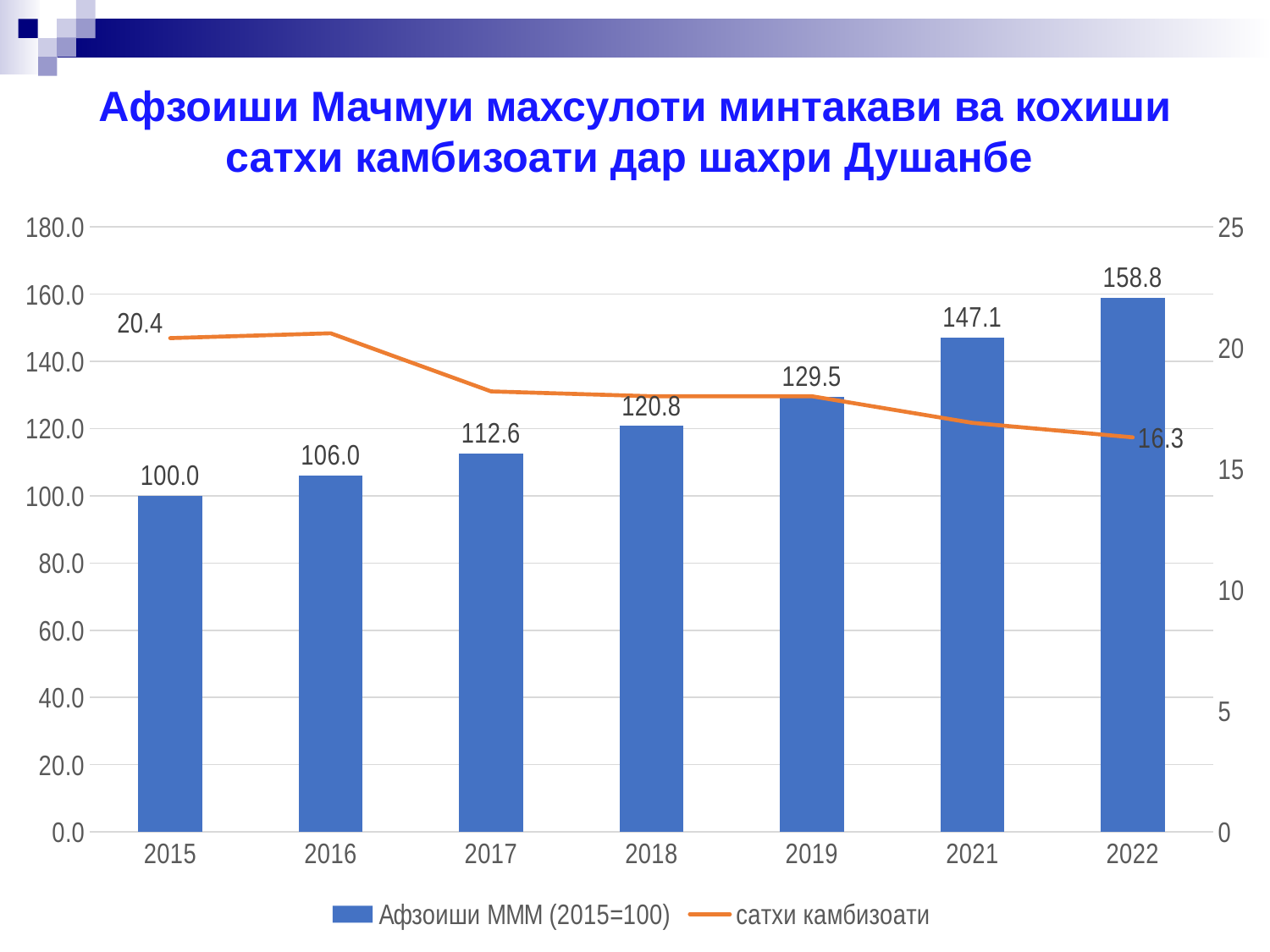
How many series does the legend list? 2 What is the value of сатхи камбизоати for 2022? 16.3 What is the value of Афзоиши ММM (2015=100) for 2021? 147.1 What is the difference between the Афзоиши ММM (2015=100) values for 2022 and 2021? 11.7 How many years are shown on the x axis? 7 Which is larger, the Афзоиши ММM (2015=100) value for 2017 or for 2019? 2019 Which year has the lowest value of Афзоиши ММM (2015=100)? 2015 What is the value of Афзоиши ММM (2015=100) for 2018? 120.8 Which year has the highest value of Афзоиши ММM (2015=100)? 2022 Do the Афзоиши ММM (2015=100) bars rise or fall from 2015 to 2022? rise What is the value of сатхи камбизоати for 2015? 20.4 Is the value of сатхи камбизоати for 2018 greater or less than 20? less